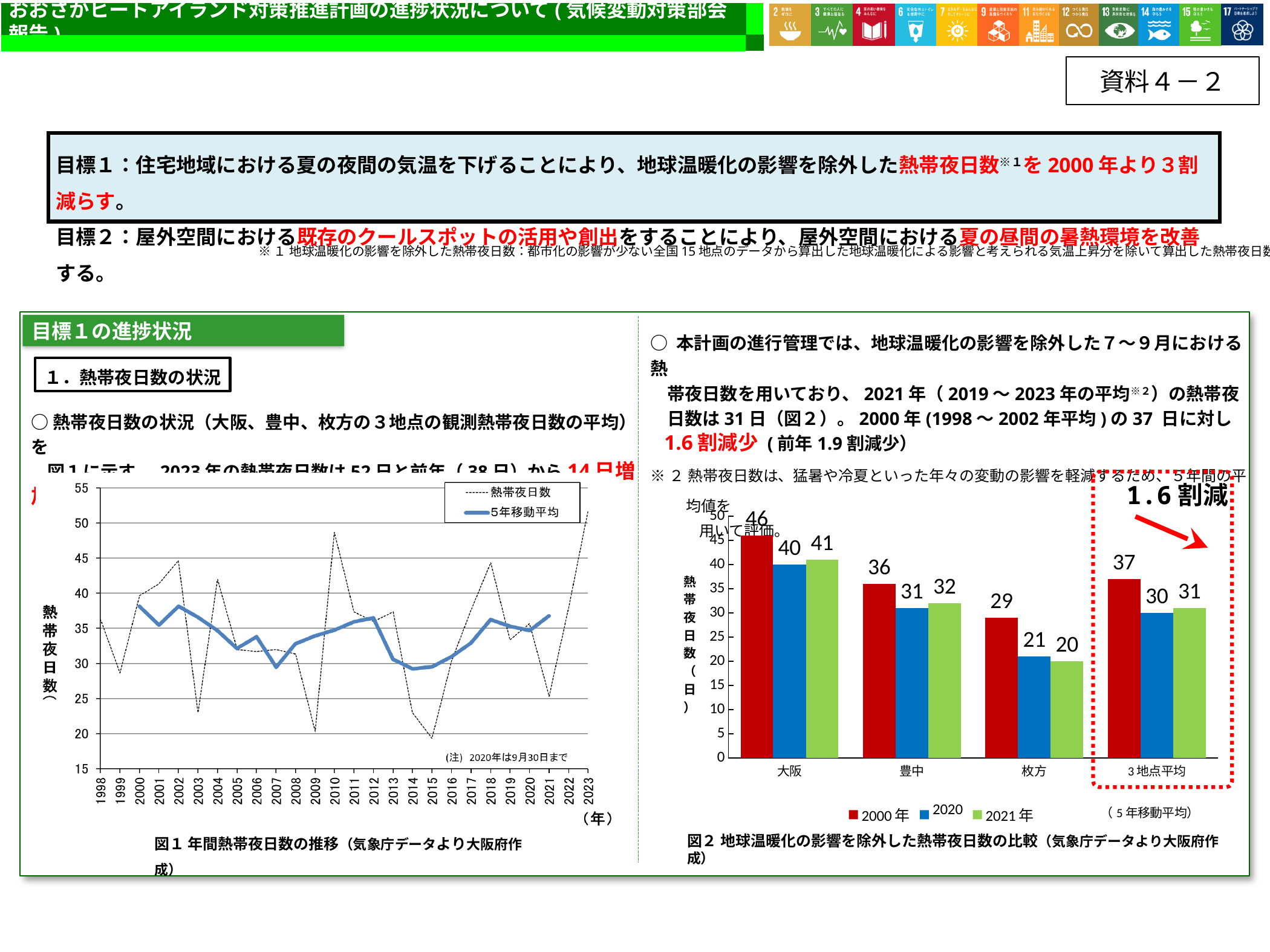
In 図2 (the bar chart on the right), which is larger for 枚方: the 2020 value or the 2021年 value? 2020 In 図2 (the bar chart on the right), what is the value for 枚方 in the 2021年 series? 20 In 図1 (the line chart on the left), how many series does the legend list? 2 In 図2 (the bar chart on the right), what is the value for 大阪 in the 2000年 series? 46 In 図2 (the bar chart on the right), which category has the lowest value in the 2021年 series? 枚方 In 図2 (the bar chart on the right), how many series does the legend list? 3 In 図1 (the line chart on the left), is the 熱帯夜日数 value for 2010 greater or less than 45? greater In 図2 (the bar chart on the right), how many categories are shown on the x axis? 4 What kind of chart is 図1 (the chart on the left)? line chart In 図2 (the bar chart on the right), what is the difference between the 2000年 and 2021年 values for 豊中? 4 In 図2 (the bar chart on the right), what is the value for 3地点平均 in the 2020 series? 30 In 図2 (the bar chart on the right), which category has the highest value in the 2000年 series? 大阪